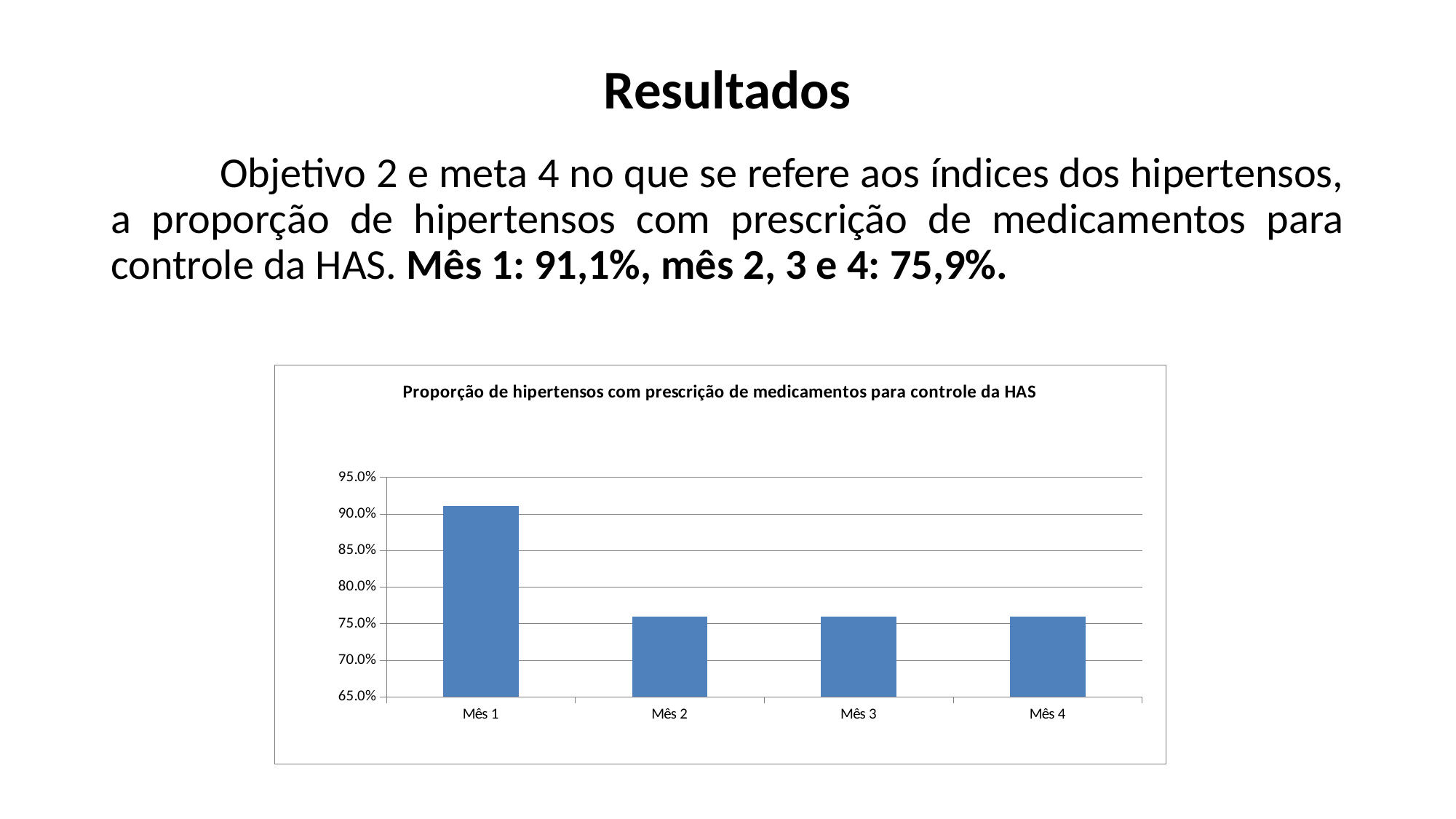
Which is larger, the value for Mês 1 or the value for Mês 2? Mês 1 What is the title of the chart? Proporção de hipertensos com prescrição de medicamentos para controle da HAS What type of chart is shown on the slide? Bar chart What is the proportion of hypertensive patients with medication prescription in Mês 3? 75,9% How many months (categories) are plotted on the x axis of the chart? 4 What is the proportion of hypertensive patients with medication prescription in Mês 1? 91,1% What is the difference in percentage points between the value for Mês 1 and the value for Mês 2? 15,2 percentage points Is the value for Mês 1 greater or less than 85.0%? greater Which month has the highest proportion of hypertensive patients with medication prescription? Mês 1 How do the values change from Mês 1 to Mês 4? They fall from Mês 1 to Mês 2 and then stay level Is the value for Mês 2 greater or less than 80.0%? less Is the value for Mês 4 greater or less than 70.0%? greater